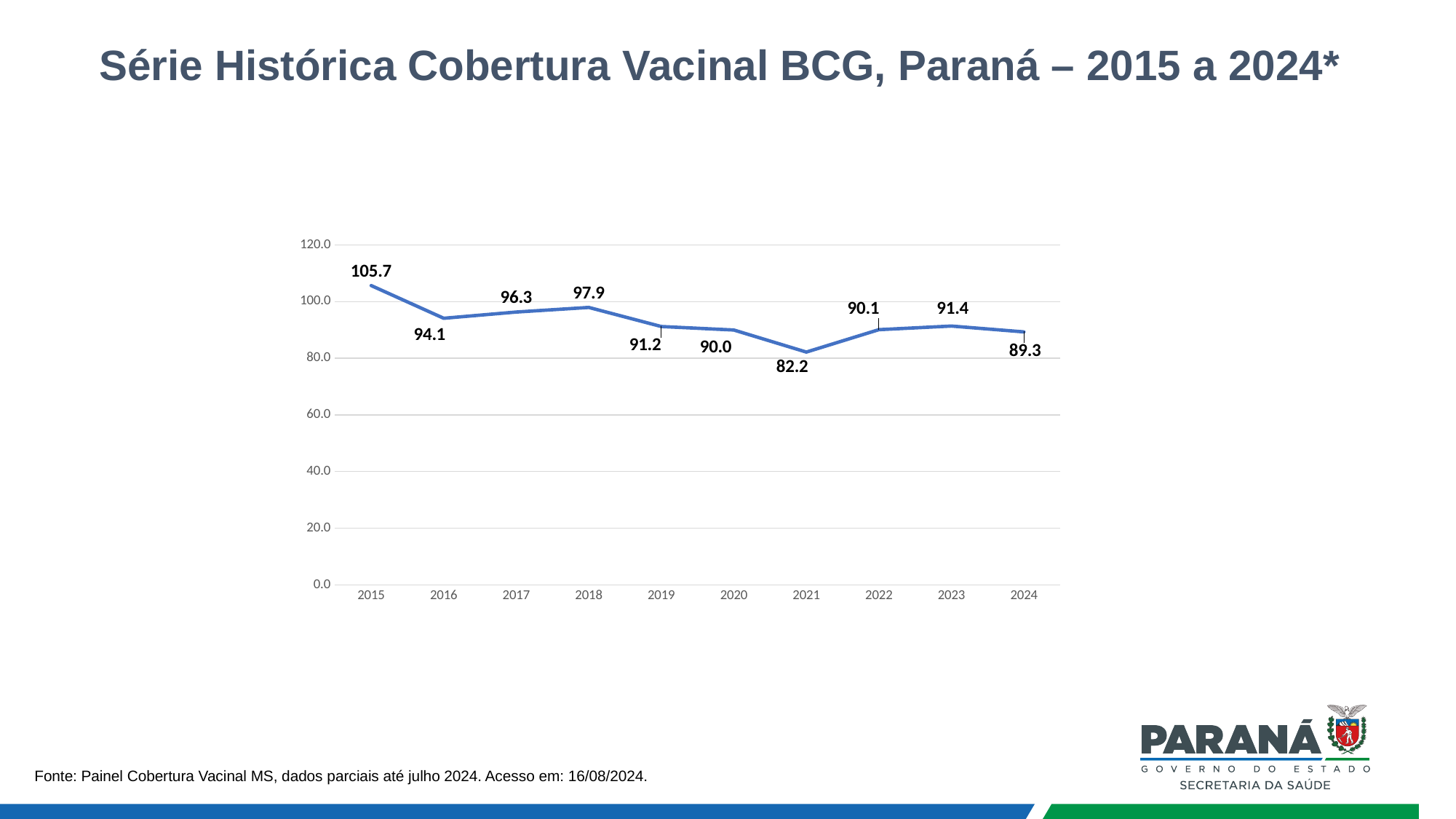
Is the value for 2015 greater or less than 100? greater What is the value shown for 2024? 89.3 What is the value plotted for 2021? 82.2 What kind of chart is shown on the slide? line chart Do the values rise or fall from 2015 to 2016? fall What is the difference between the 2018 value and the 2019 value? 6.7 What is the difference between the 2015 value and the 2021 value? 23.5 Which year has the highest value on the chart? 2015 Which year has a larger value, 2017 or 2018? 2018 Which year has the lowest value on the chart? 2021 What is the BCG vaccination coverage value for 2015? 105.7 How many years are plotted on the x axis? 10